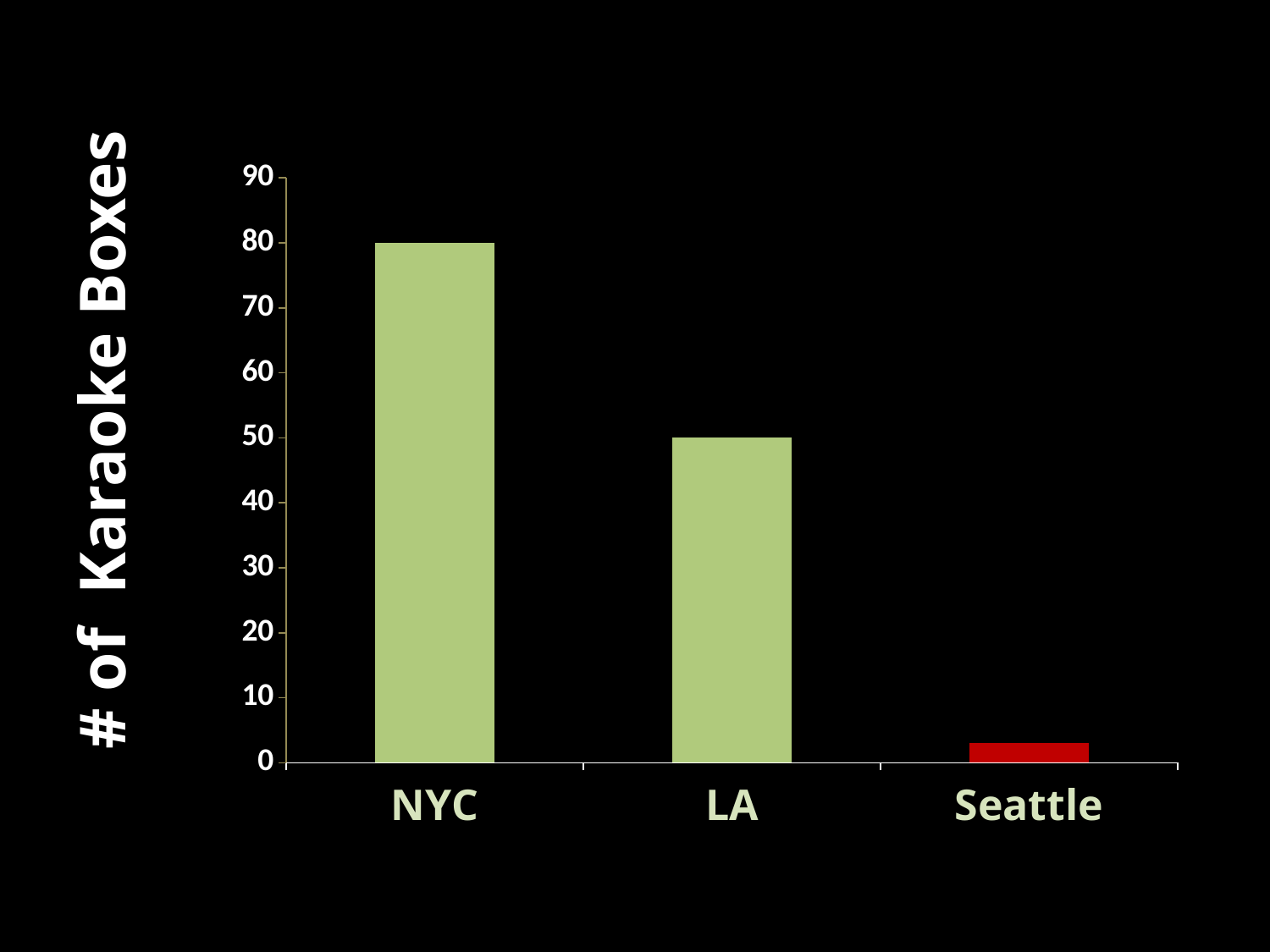
How many categories are shown on the x axis? 3 What is the label on the vertical axis? # of Karaoke Boxes Is the value for NYC greater or less than 70? greater What is the difference between the values for NYC and LA? 30 Do the values rise or fall from left to right along the x axis? fall What kind of chart is shown on the slide? bar chart What is the value for NYC? 80 Is the value for Seattle greater or less than 10? less What is the value for LA? 50 Which is larger, the value for LA or the value for Seattle? LA Which category has the lowest value? Seattle Which category has the highest value? NYC